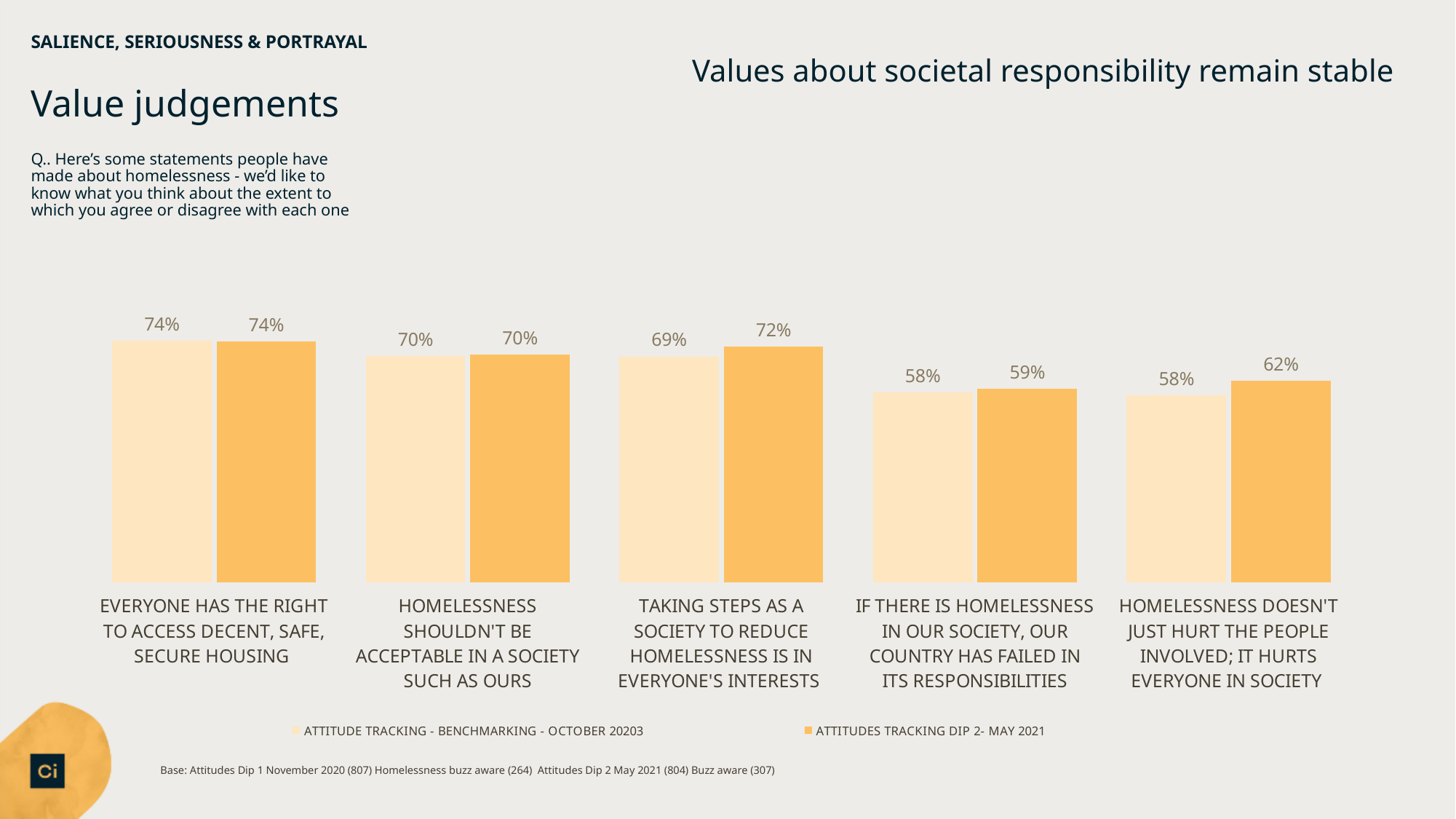
How many series does the legend list? 2 Which statement has the lowest value in the Attitudes Tracking Dip 2 - May 2021 series? If there is homelessness in our society, our country has failed in its responsibilities What kind of chart is shown on the slide? Bar chart What is the difference between the May 2021 and October benchmarking values for 'Homelessness doesn't just hurt the people involved; it hurts everyone in society'? 4% Which legend entry is shown in the darker orange colour? Attitudes Tracking Dip 2 - May 2021 What is the value for 'Taking steps as a society to reduce homelessness is in everyone's interests' in the Attitude Tracking - Benchmarking - October 20203 series? 69% How many statements (categories) are shown on the chart? 5 Which statement has the highest value in the Attitudes Tracking Dip 2 - May 2021 series? Everyone has the right to access decent, safe, secure housing What is the difference between the May 2021 and October benchmarking values for 'Taking steps as a society to reduce homelessness is in everyone's interests'? 3% In the Attitudes Tracking Dip 2 - May 2021 series, which is larger: 'Homelessness shouldn't be acceptable in a society such as ours' or 'If there is homelessness in our society, our country has failed in its responsibilities'? Homelessness shouldn't be acceptable in a society such as ours What is the value for 'Everyone has the right to access decent, safe, secure housing' in the Attitudes Tracking Dip 2 - May 2021 series? 74% What is the value for 'Homelessness doesn't just hurt the people involved; it hurts everyone in society' in the Attitudes Tracking Dip 2 - May 2021 series? 62%